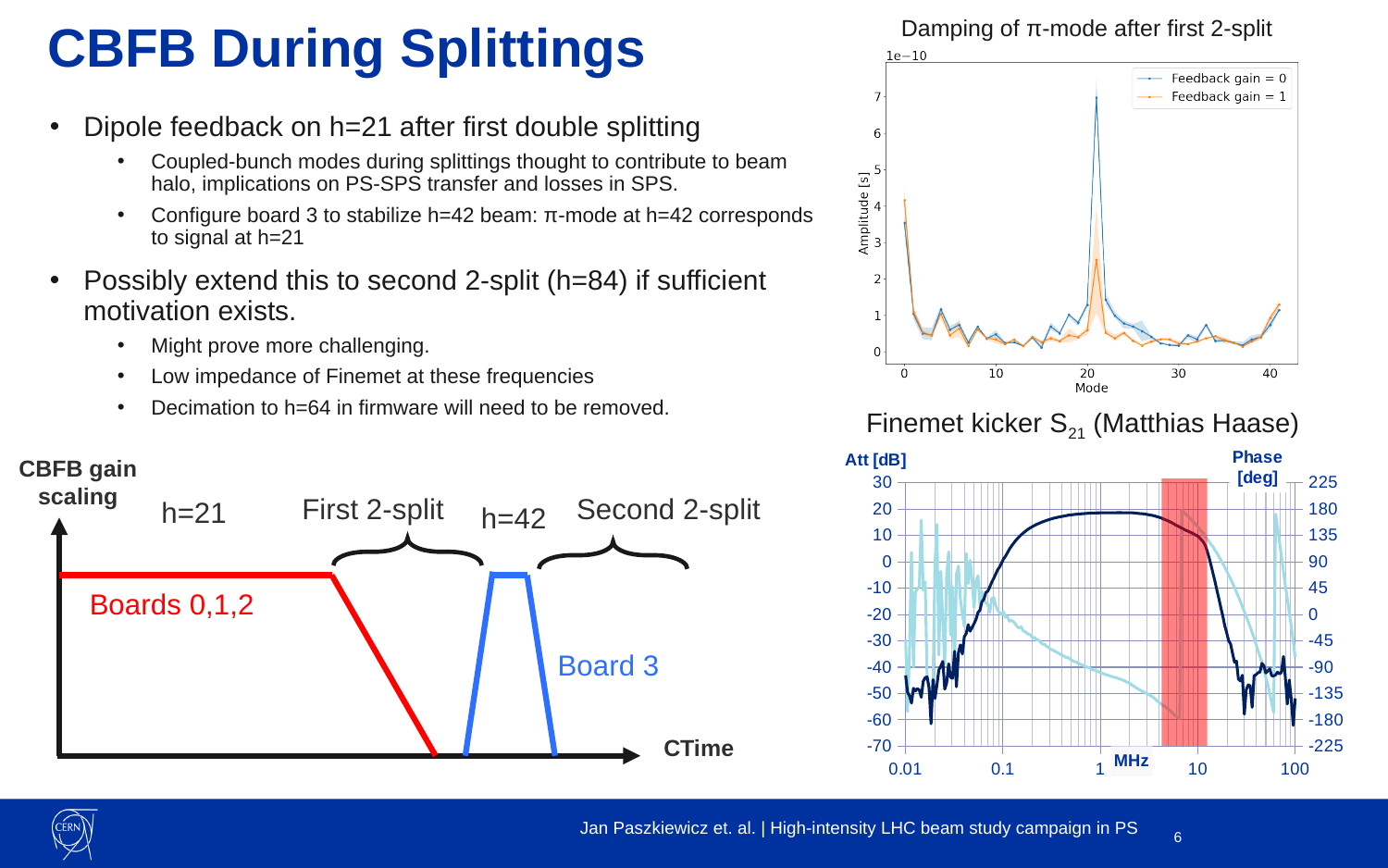
In the chart titled "Finemet kicker S21 (Matthias Haase)", what is the highest value shown on the left Att [dB] axis? 30 In the chart titled "Damping of π-mode after first 2-split", is the peak amplitude of the Feedback gain = 1 series greater or less than 3? less In the chart titled "Damping of π-mode after first 2-split", which series reaches the higher peak amplitude near mode 21? Feedback gain = 0 In the chart titled "Finemet kicker S21 (Matthias Haase)", does the attenuation (dark curve) rise or fall between 10 MHz and 100 MHz? fall In the chart titled "Damping of π-mode after first 2-split", how many series does the legend list? 2 In the chart titled "Damping of π-mode after first 2-split", what kind of chart is shown? line chart In the chart titled "Finemet kicker S21 (Matthias Haase)", how many tick labels are printed on the MHz x axis? 5 In the chart titled "Damping of π-mode after first 2-split", what is the label of the x axis? Mode In the chart titled "Finemet kicker S21 (Matthias Haase)", what is the lowest value shown on the right Phase [deg] axis? -225 In the chart titled "Finemet kicker S21 (Matthias Haase)", is the attenuation (dark curve) at 1 MHz greater or less than 10 dB? greater In the chart titled "Damping of π-mode after first 2-split", what are the two legend entries? Feedback gain = 0 and Feedback gain = 1 In the chart titled "Damping of π-mode after first 2-split", is the peak amplitude of the Feedback gain = 0 series greater or less than 6? greater